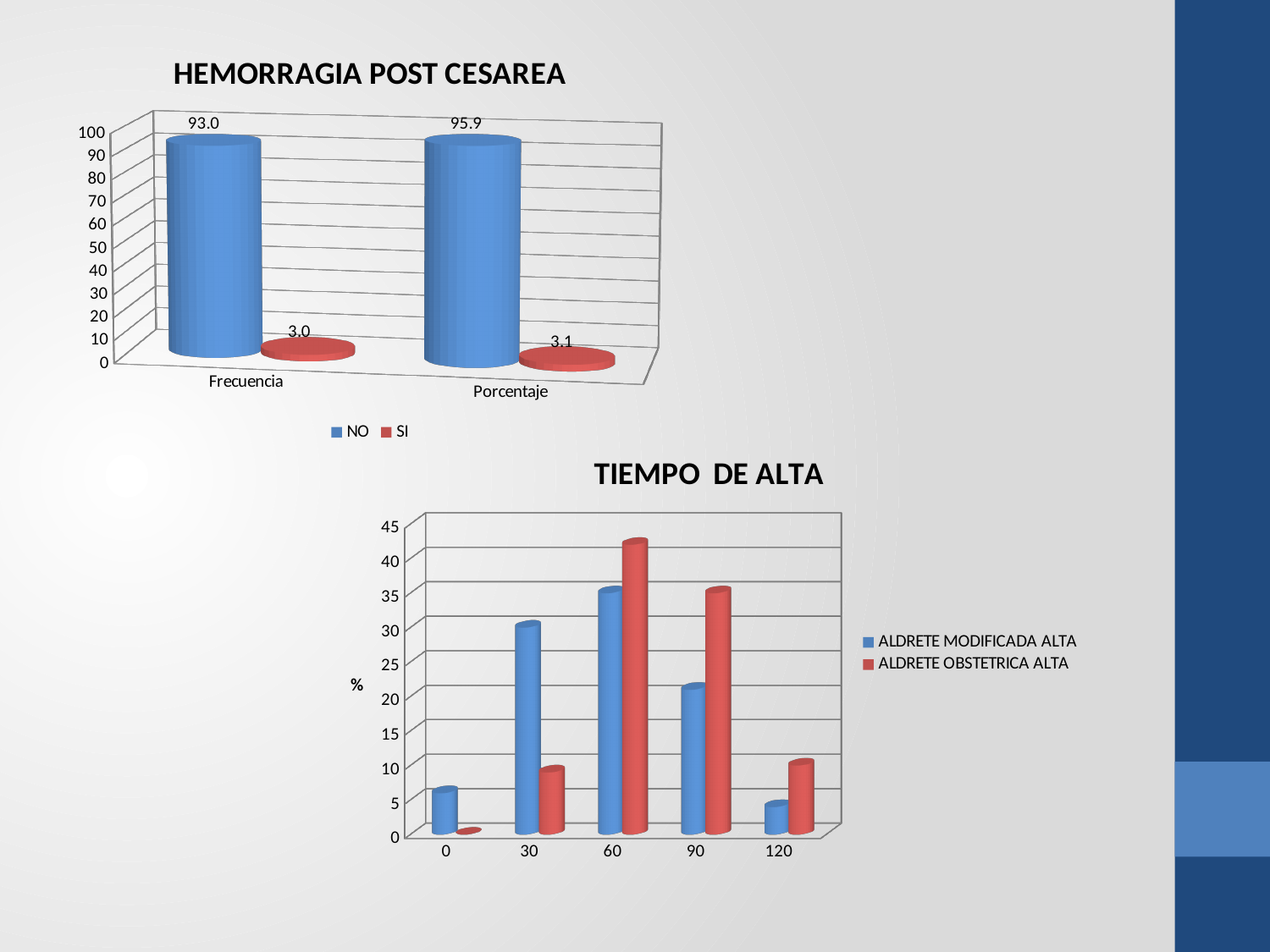
In the TIEMPO DE ALTA chart, which category has the lowest value for ALDRETE OBSTETRICA ALTA? 0 In the TIEMPO DE ALTA chart, how many categories are shown on the x axis? 5 What label is shown on the vertical axis of the TIEMPO DE ALTA chart? % In the HEMORRAGIA POST CESAREA chart, what is the difference between NO and SI for Frecuencia? 90.0 In the TIEMPO DE ALTA chart, which series has the larger value at 90, ALDRETE MODIFICADA ALTA or ALDRETE OBSTETRICA ALTA? ALDRETE OBSTETRICA ALTA In the TIEMPO DE ALTA chart, is the value for ALDRETE MODIFICADA ALTA at 30 greater or less than 25? greater In the HEMORRAGIA POST CESAREA chart, what is the value of SI for Porcentaje? 3.1 What kind of chart is the HEMORRAGIA POST CESAREA chart? Bar chart How many series does the legend of the HEMORRAGIA POST CESAREA chart list? 2 In the TIEMPO DE ALTA chart, which category has the highest value for ALDRETE OBSTETRICA ALTA? 60 In the HEMORRAGIA POST CESAREA chart, which series has the larger value for Porcentaje, NO or SI? NO In the HEMORRAGIA POST CESAREA chart, what is the value of NO for Frecuencia? 93.0